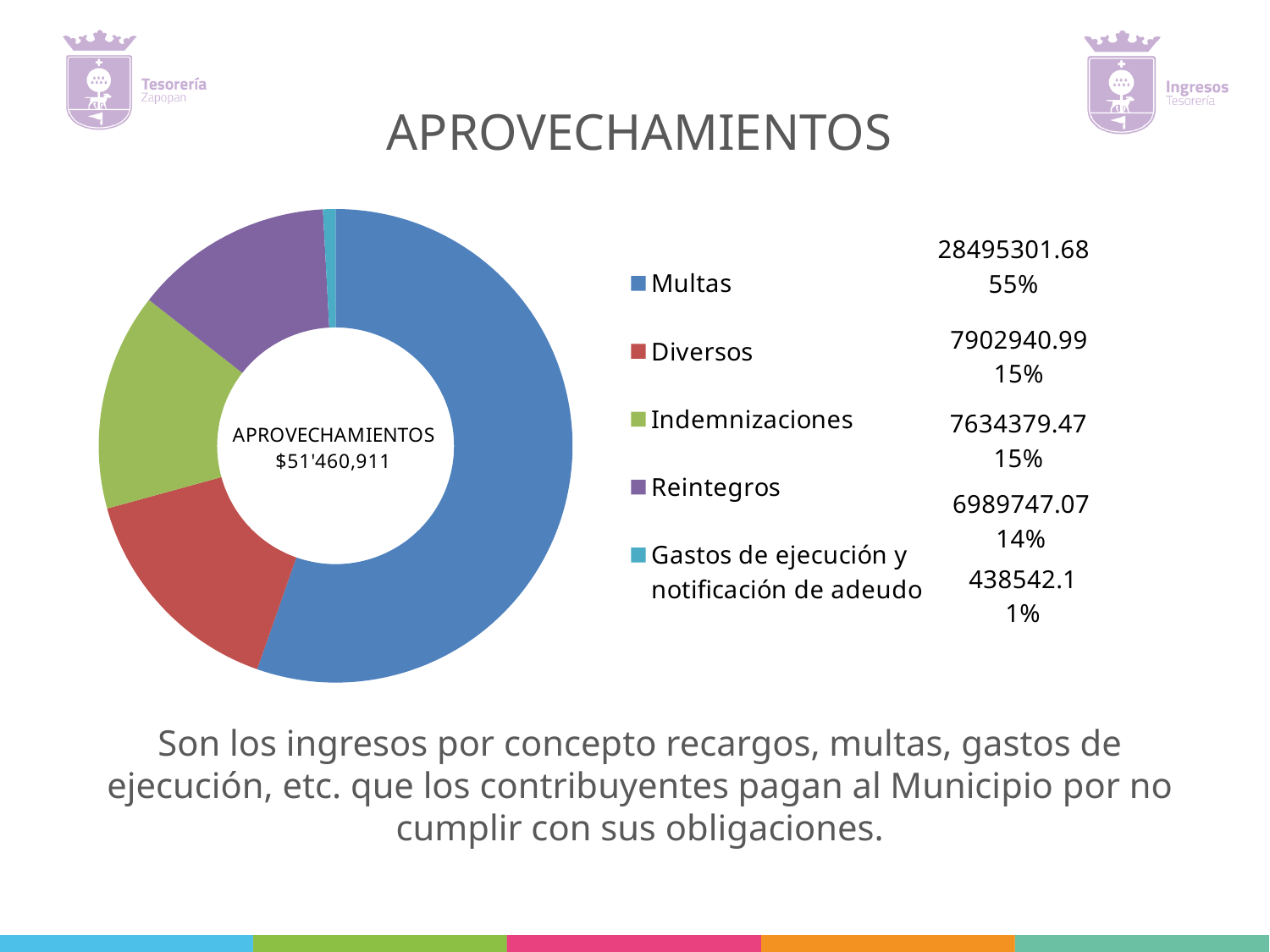
Which category has the largest share of the chart? Multas What kind of chart is shown on the slide? doughnut (pie) chart What is the value shown for Diversos? 7902940.99 What is the value shown for Multas? 28495301.68 Which category has the smallest share of the chart? Gastos de ejecución y notificación de adeudo What percentage share does Reintegros have? 14% What is the difference between the values for Multas and Diversos? 20592360.69 What is the value shown for Reintegros? 6989747.07 How many categories does the APROVECHAMIENTOS chart show? 5 What total amount is shown in the centre of the chart? $51'460,911 What is the value shown for Gastos de ejecución y notificación de adeudo? 438542.1 What percentage share does Multas have? 55%